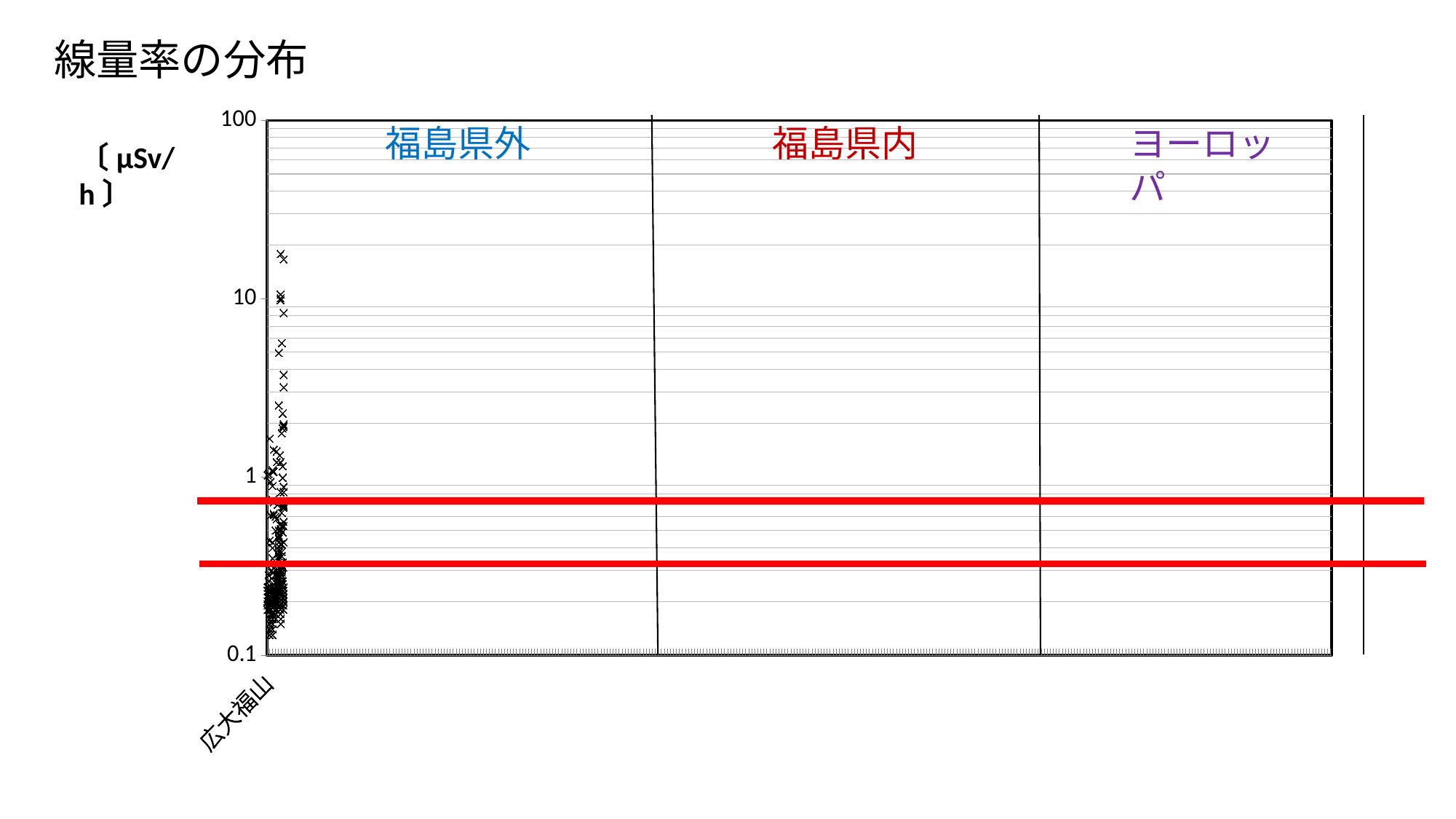
What is the highest tick value shown on the y axis? 100 What is the title of the chart? 線量率の分布 What unit is shown for the y axis of the chart? μSv/h What is the lowest tick value shown on the y axis? 0.1 How many region labels (福島県外, 福島県内, ヨーロッパ) are written across the top of the chart? 3 What kind of chart is shown on the slide? scatter chart Is the lowest plotted value for 広大福山 greater or less than 1? less Which category label is shown on the x axis of the chart? 広大福山 Is the highest plotted value for 広大福山 greater or less than 100? less Is the highest plotted value for 広大福山 greater or less than 10? greater